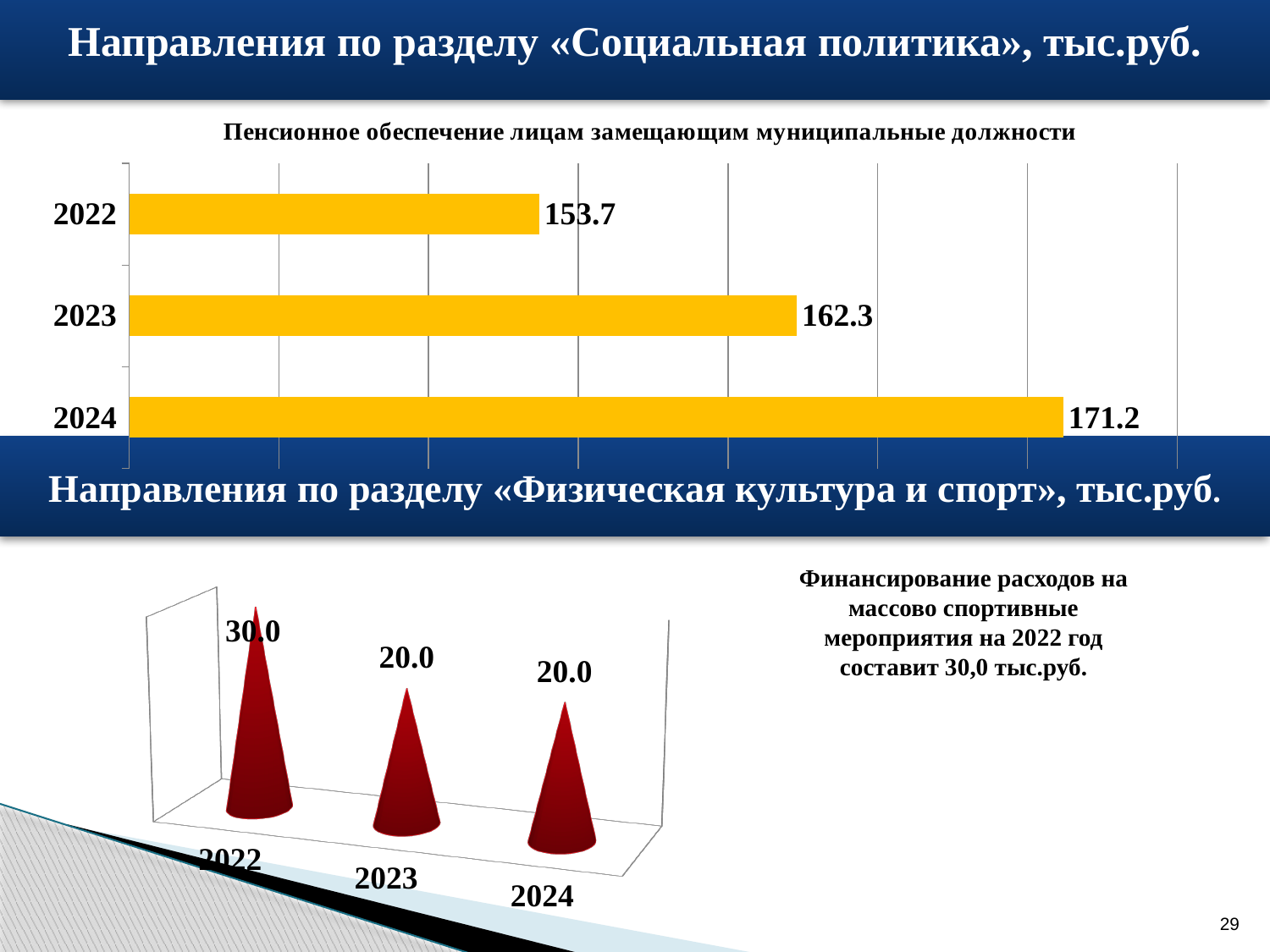
What kind of chart is the one titled «Пенсионное обеспечение лицам замещающим муниципальные должности»? bar chart In the chart at the bottom of the slide under «Физическая культура и спорт», what is the value for 2023? 20.0 In the chart titled «Пенсионное обеспечение лицам замещающим муниципальные должности», do the values rise or fall from 2022 to 2024? rise In the chart at the bottom of the slide under «Физическая культура и спорт», which year has the highest value? 2022 In the chart titled «Пенсионное обеспечение лицам замещающим муниципальные должности», what is the value for 2022? 153.7 In the chart titled «Пенсионное обеспечение лицам замещающим муниципальные должности», which year has the highest value? 2024 How many years are shown in the chart titled «Пенсионное обеспечение лицам замещающим муниципальные должности»? 3 In the chart titled «Пенсионное обеспечение лицам замещающим муниципальные должности», which year has the lowest value? 2022 In the chart at the bottom of the slide under «Физическая культура и спорт», what is the difference between the 2022 and 2024 values? 10.0 In the chart titled «Пенсионное обеспечение лицам замещающим муниципальные должности», what is the value for 2024? 171.2 In the chart at the bottom of the slide under «Физическая культура и спорт», what is the value for 2022? 30.0 In the chart titled «Пенсионное обеспечение лицам замещающим муниципальные должности», what is the difference between the 2024 and 2022 values? 17.5